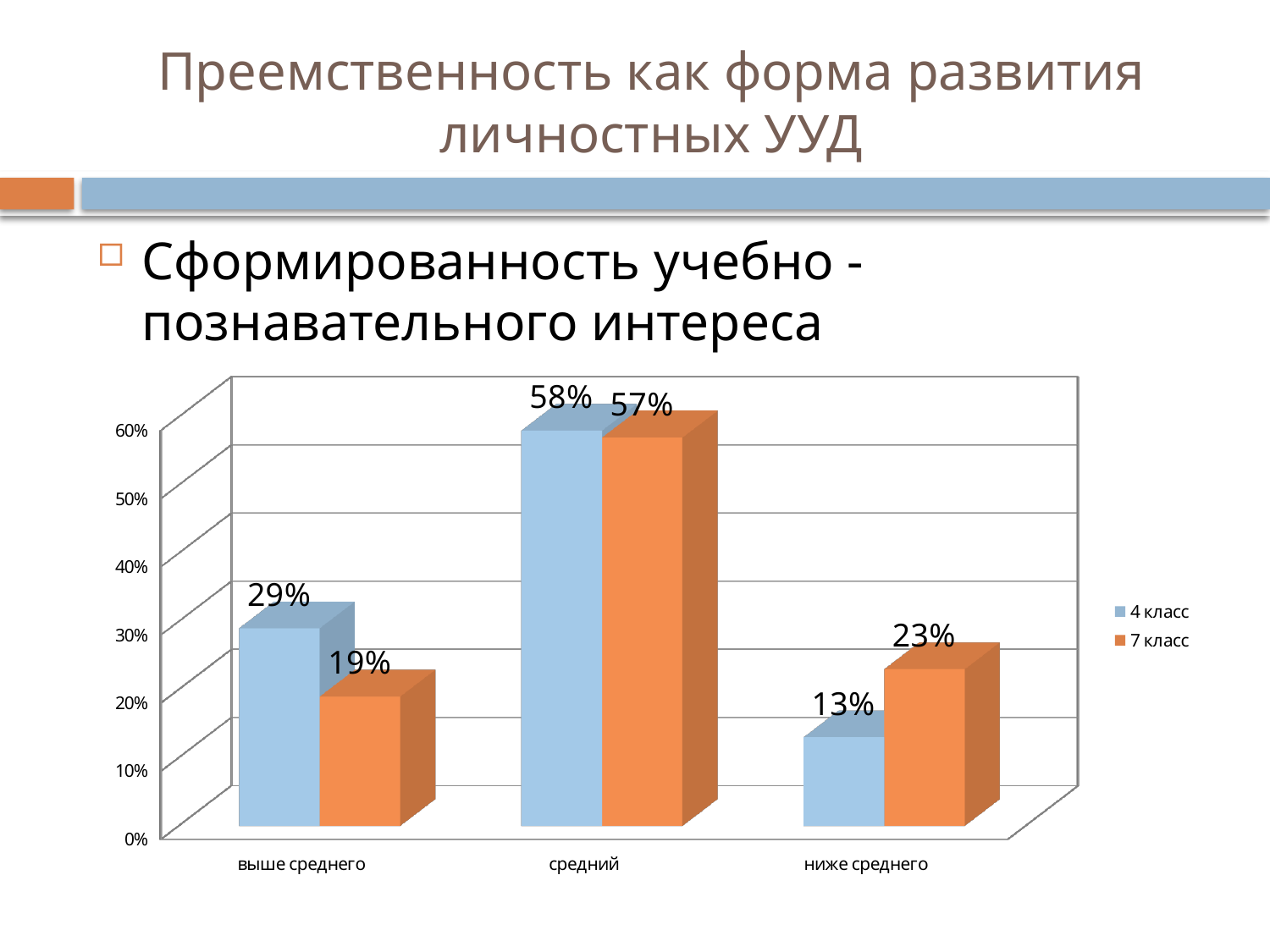
What is the value for 7 класс in the ниже среднего category? 23% In the ниже среднего category, which series has the larger value, 4 класс or 7 класс? 7 класс What is the value for 7 класс in the средний category? 57% What is the difference between the 4 класс and 7 класс values in the выше среднего category? 10% Which category has the lowest value for 7 класс? выше среднего Which category has the highest value for 4 класс? средний What is the difference between the 7 класс and 4 класс values in the ниже среднего category? 10% What is the value for 4 класс in the выше среднего category? 29% How many categories are shown on the x axis? 3 How many series does the legend list? 2 What kind of chart is shown on the slide? bar chart Which colour represents 7 класс in the legend? orange